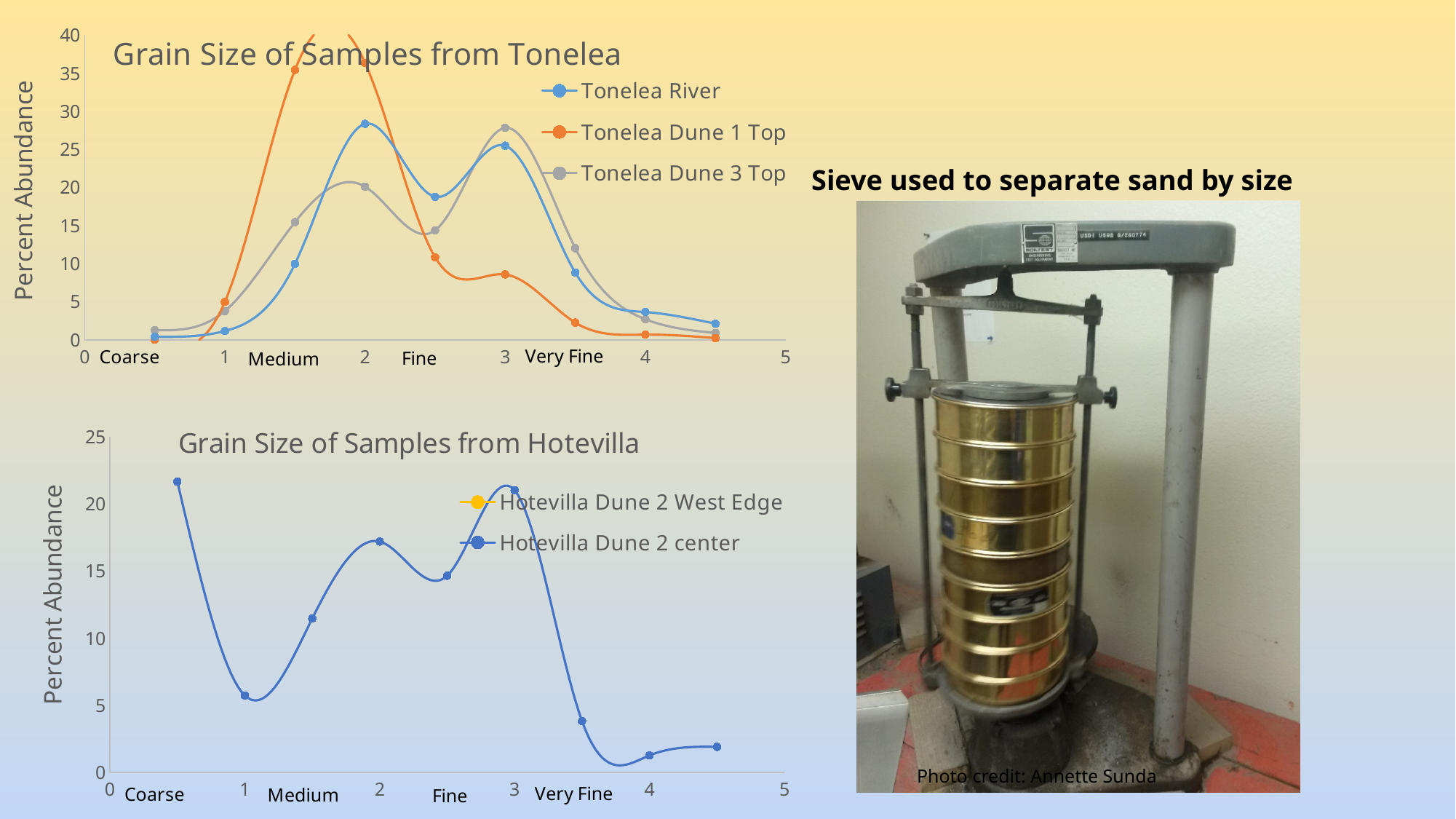
In the 'Grain Size of Samples from Tonelea' chart, at x = 2, which is larger: Tonelea Dune 1 Top or Tonelea River? Tonelea Dune 1 Top In the 'Grain Size of Samples from Tonelea' chart, which series reaches the highest peak? Tonelea Dune 1 Top What kind of chart is 'Grain Size of Samples from Tonelea'? Line chart In the 'Grain Size of Samples from Hotevilla' chart, is the value for Hotevilla Dune 2 center at x = 1 greater or less than 10? less What is the y-axis title of the 'Grain Size of Samples from Tonelea' chart? Percent Abundance In the 'Grain Size of Samples from Tonelea' chart, how many series does the legend list? 3 In the 'Grain Size of Samples from Tonelea' chart, is the value for Tonelea River at x = 2 greater or less than 25? greater In the 'Grain Size of Samples from Hotevilla' chart, how many series does the legend list? 2 In the 'Grain Size of Samples from Hotevilla' chart, does the Hotevilla Dune 2 center line rise or fall between x = 3 and x = 4? fall In the 'Grain Size of Samples from Tonelea' chart, at x = 3, which is larger: Tonelea Dune 3 Top or Tonelea Dune 1 Top? Tonelea Dune 3 Top In the 'Grain Size of Samples from Tonelea' chart, is the value for Tonelea Dune 1 Top at x = 3 greater or less than 10? less